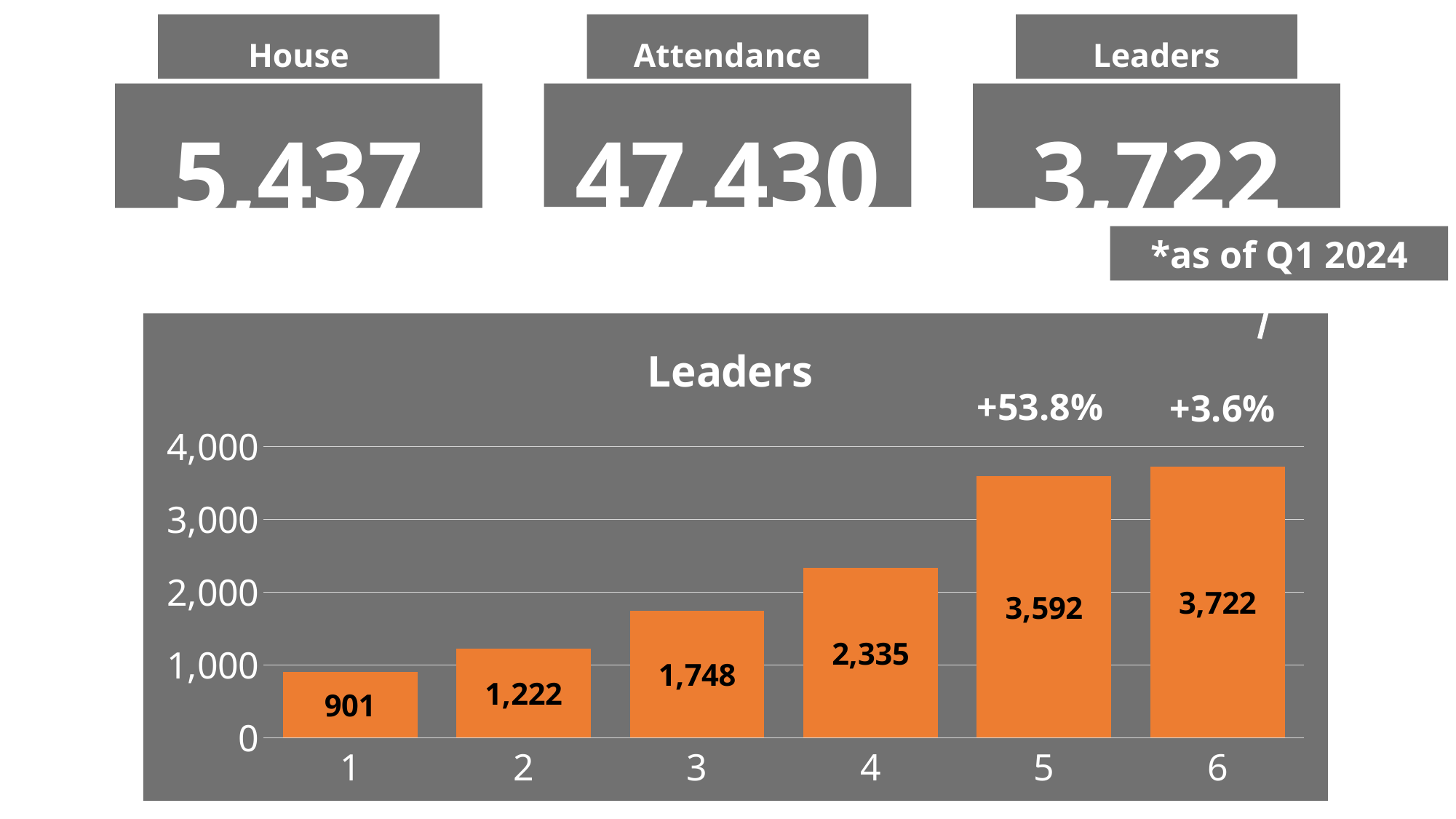
What is the difference between the values for category 3 and category 2 in the Leaders chart? 526 What is the value for category 4 in the Leaders chart? 2,335 Which category has the lowest value in the Leaders chart? 1 What is the difference between the values for category 6 and category 5 in the Leaders chart? 130 What is the value for category 6 in the Leaders chart? 3,722 Is the value for category 5 in the Leaders chart greater or less than 3,000? greater Which category has the highest value in the Leaders chart? 6 What kind of chart is the Leaders chart? bar chart Do the values in the Leaders chart rise or fall from category 1 to category 6? rise How many bars are in the Leaders chart? 6 Which is larger in the Leaders chart, the value for category 3 or category 4? 4 What is the value for category 1 in the Leaders chart? 901